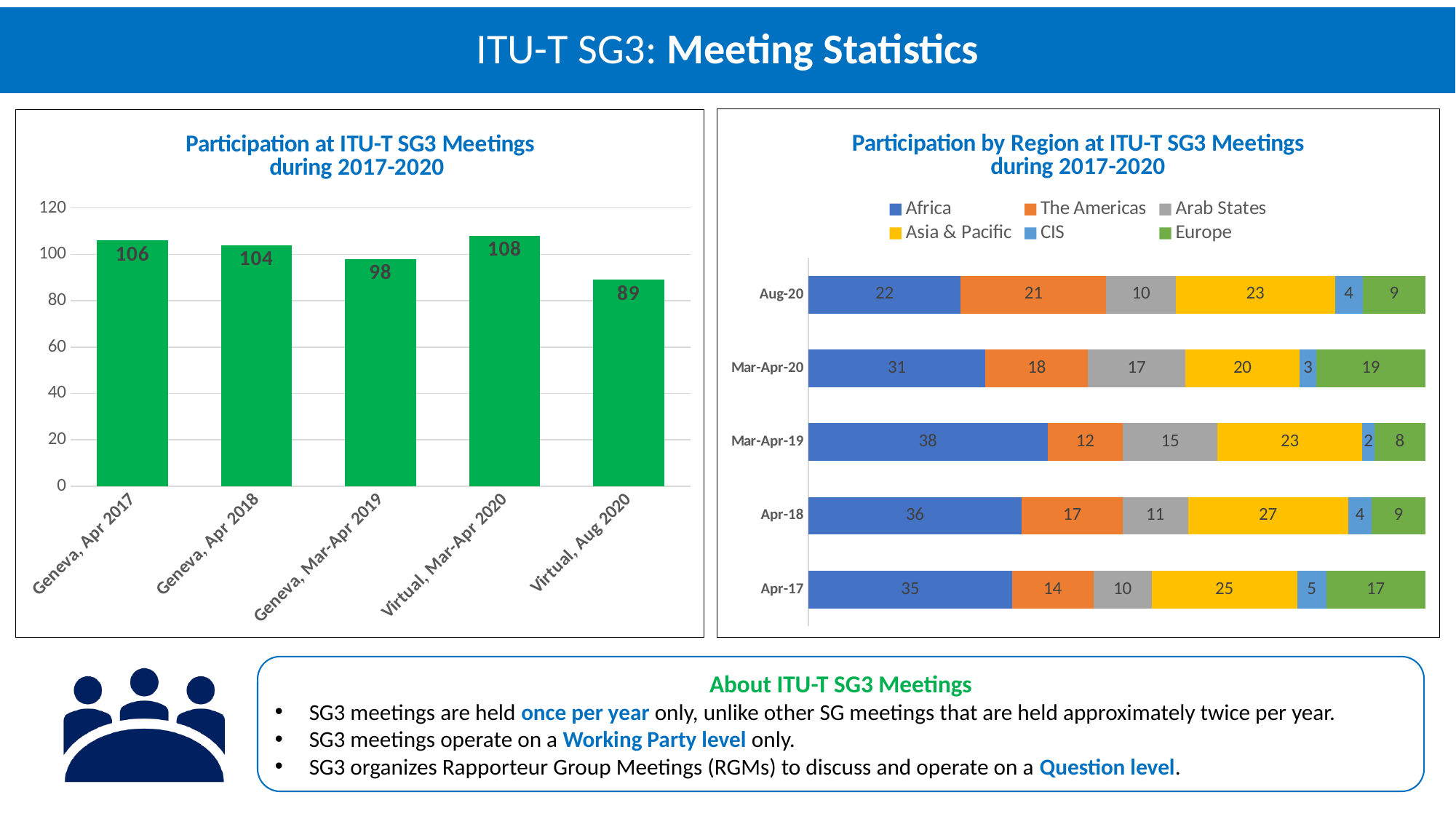
In the 'Participation at ITU-T SG3 Meetings during 2017-2020' chart, how many meetings are shown? 5 In the 'Participation by Region at ITU-T SG3 Meetings during 2017-2020' chart, which colour represents Asia & Pacific? Yellow In the 'Participation by Region at ITU-T SG3 Meetings during 2017-2020' chart, how many series does the legend list? 6 In the 'Participation at ITU-T SG3 Meetings during 2017-2020' chart, which meeting has the highest participation? Virtual, Mar-Apr 2020 In the 'Participation by Region at ITU-T SG3 Meetings during 2017-2020' chart, what is the value for Africa at Mar-Apr-19? 38 In the 'Participation by Region at ITU-T SG3 Meetings during 2017-2020' chart, what is the total of the Aug-20 bar? 89 In the 'Participation by Region at ITU-T SG3 Meetings during 2017-2020' chart, what is the value for Europe at Apr-17? 17 In the 'Participation by Region at ITU-T SG3 Meetings during 2017-2020' chart, which is larger at Mar-Apr-20: The Americas or Arab States? The Americas In the 'Participation at ITU-T SG3 Meetings during 2017-2020' chart, what is the value for Virtual, Aug 2020? 89 What kind of chart is the 'Participation at ITU-T SG3 Meetings during 2017-2020' chart? Bar chart In the 'Participation at ITU-T SG3 Meetings during 2017-2020' chart, which meeting has the lowest participation? Virtual, Aug 2020 In the 'Participation at ITU-T SG3 Meetings during 2017-2020' chart, what is the difference between Geneva, Apr 2017 and Geneva, Mar-Apr 2019? 8